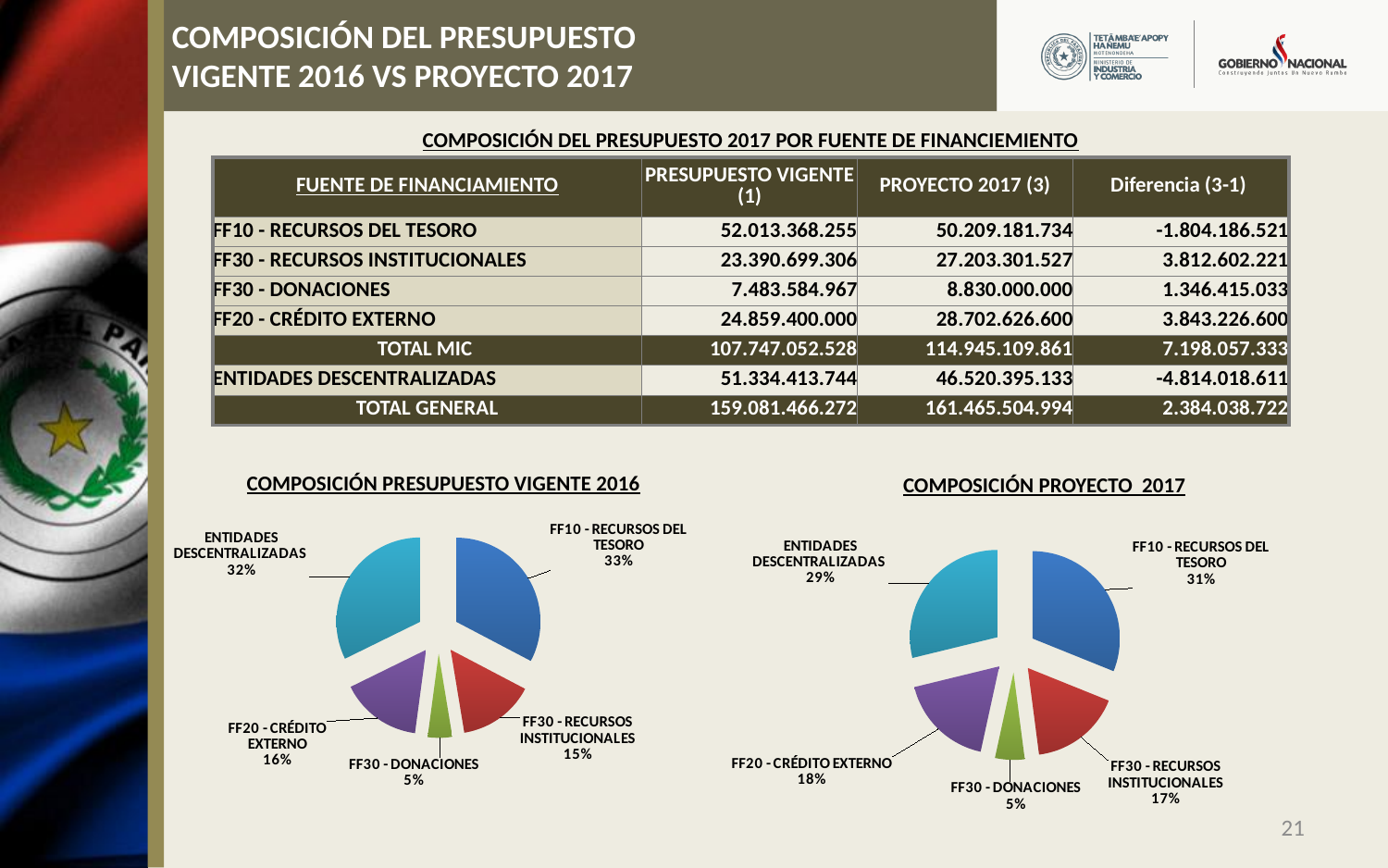
In the COMPOSICIÓN PROYECTO 2017 chart, which is larger: FF30 - RECURSOS INSTITUCIONALES or FF30 - DONACIONES? FF30 - RECURSOS INSTITUCIONALES What kind of chart is COMPOSICIÓN PROYECTO 2017? Pie chart In the COMPOSICIÓN PROYECTO 2017 chart, which category has the largest share? FF10 - RECURSOS DEL TESORO In the COMPOSICIÓN PRESUPUESTO VIGENTE 2016 chart, what is the difference in percentage points between ENTIDADES DESCENTRALIZADAS and FF20 - CRÉDITO EXTERNO? 16 How many slices does the COMPOSICIÓN PRESUPUESTO VIGENTE 2016 chart have? 5 In the COMPOSICIÓN PROYECTO 2017 chart, what share does FF20 - CRÉDITO EXTERNO have? 18% In the COMPOSICIÓN PRESUPUESTO VIGENTE 2016 chart, which category has the smallest share? FF30 - DONACIONES In the COMPOSICIÓN PROYECTO 2017 chart, what share does ENTIDADES DESCENTRALIZADAS have? 29% In the COMPOSICIÓN PROYECTO 2017 chart, what is the difference in percentage points between FF10 - RECURSOS DEL TESORO and FF30 - RECURSOS INSTITUCIONALES? 14 In the COMPOSICIÓN PRESUPUESTO VIGENTE 2016 chart, what share does FF30 - RECURSOS INSTITUCIONALES have? 15% In the COMPOSICIÓN PRESUPUESTO VIGENTE 2016 chart, what share does FF10 - RECURSOS DEL TESORO have? 33% How many pie charts are shown on the slide? 2